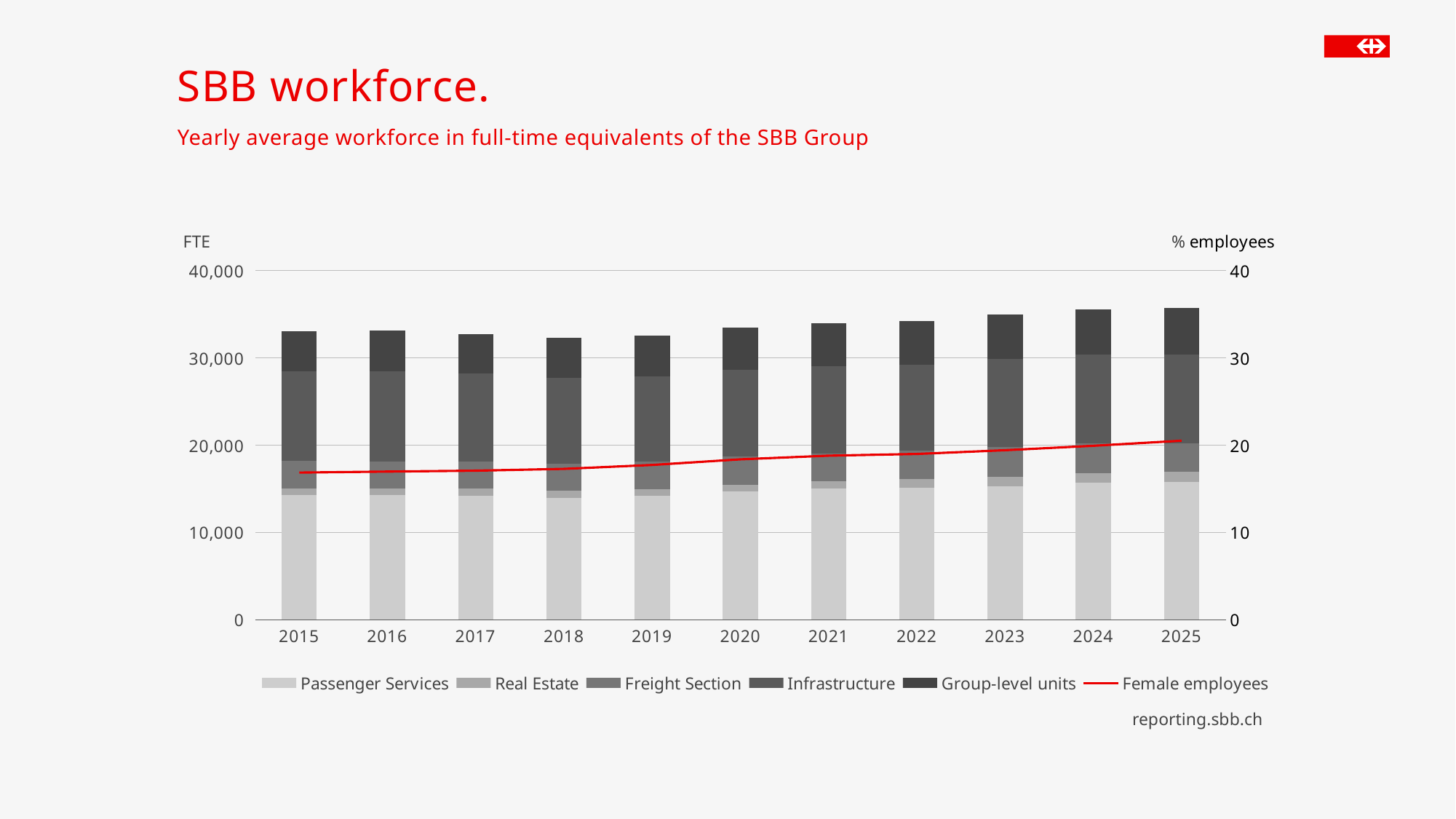
What is the title of the chart on the slide? SBB workforce. Is the Female employees value for 2020 greater or less than 10%? greater Does the Female employees line rise or fall from 2015 to 2025? Rises How many years are shown along the x axis of the chart? 11 Is the total workforce (FTE) for 2018 greater or less than 40,000? less How many series does the chart legend list? 6 Which year has the larger total workforce (FTE), 2018 or 2023? 2023 What kind of chart is shown on the slide? Stacked bar chart with a line Which series is drawn as a red line rather than as bars? Female employees Is the total workforce (FTE) for 2025 greater or less than 30,000? greater Which year has the larger total workforce (FTE), 2015 or 2025? 2025